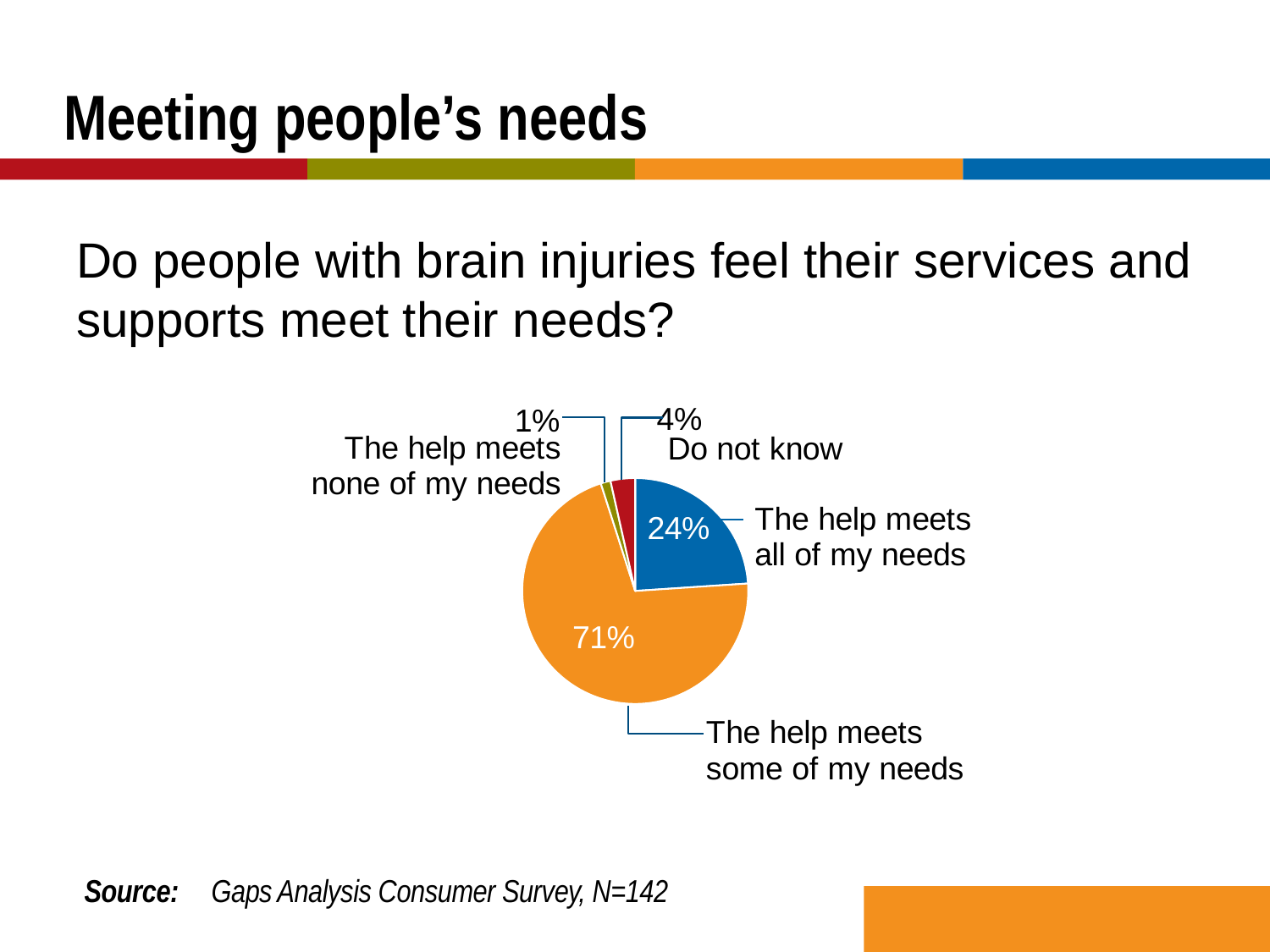
Which response has the largest share of the pie? The help meets some of my needs Which is larger: the share for 'Do not know' or the share for 'The help meets none of my needs'? Do not know Which response has the smallest share of the pie? The help meets none of my needs What is the sample size (N) given in the source note below the chart? 142 What percentage of respondents said the help meets all of my needs? 24% What is the difference in percentage points between 'The help meets some of my needs' and 'The help meets all of my needs'? 47 What percentage of respondents said the help meets some of my needs? 71% How many slices does the pie chart have? 4 What percentage of respondents said the help meets none of my needs? 1% What colour is the slice for 'The help meets all of my needs'? blue What kind of chart is shown on the slide? pie chart What percentage of respondents answered Do not know? 4%